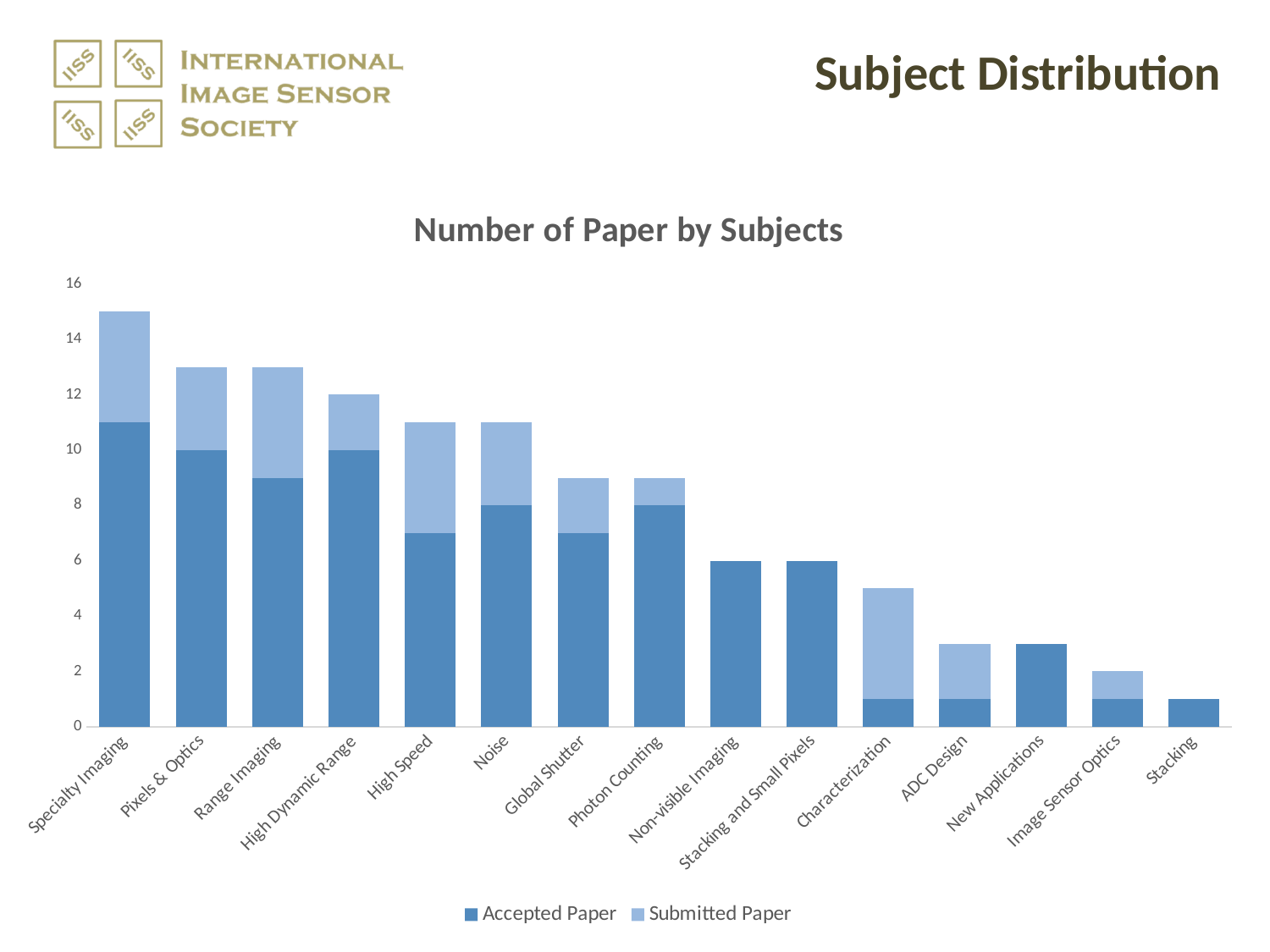
What is the total height of the bar for Non-visible Imaging? 6 What is the title of the chart? Number of Paper by Subjects What is the Accepted Paper value for Noise? 8 What type of chart is shown on the slide? Stacked bar chart How many subject categories are shown on the x axis? 15 Do the total bar heights generally rise or fall from left to right along the x axis? fall Is the total bar for Specialty Imaging greater or less than 14? greater Which subject has the tallest total bar? Specialty Imaging Is the Accepted Paper value for Characterization greater or less than 2? less What is the Accepted Paper value for Pixels & Optics? 10 How many series does the legend list? 2 Which subject has the shortest total bar? Stacking